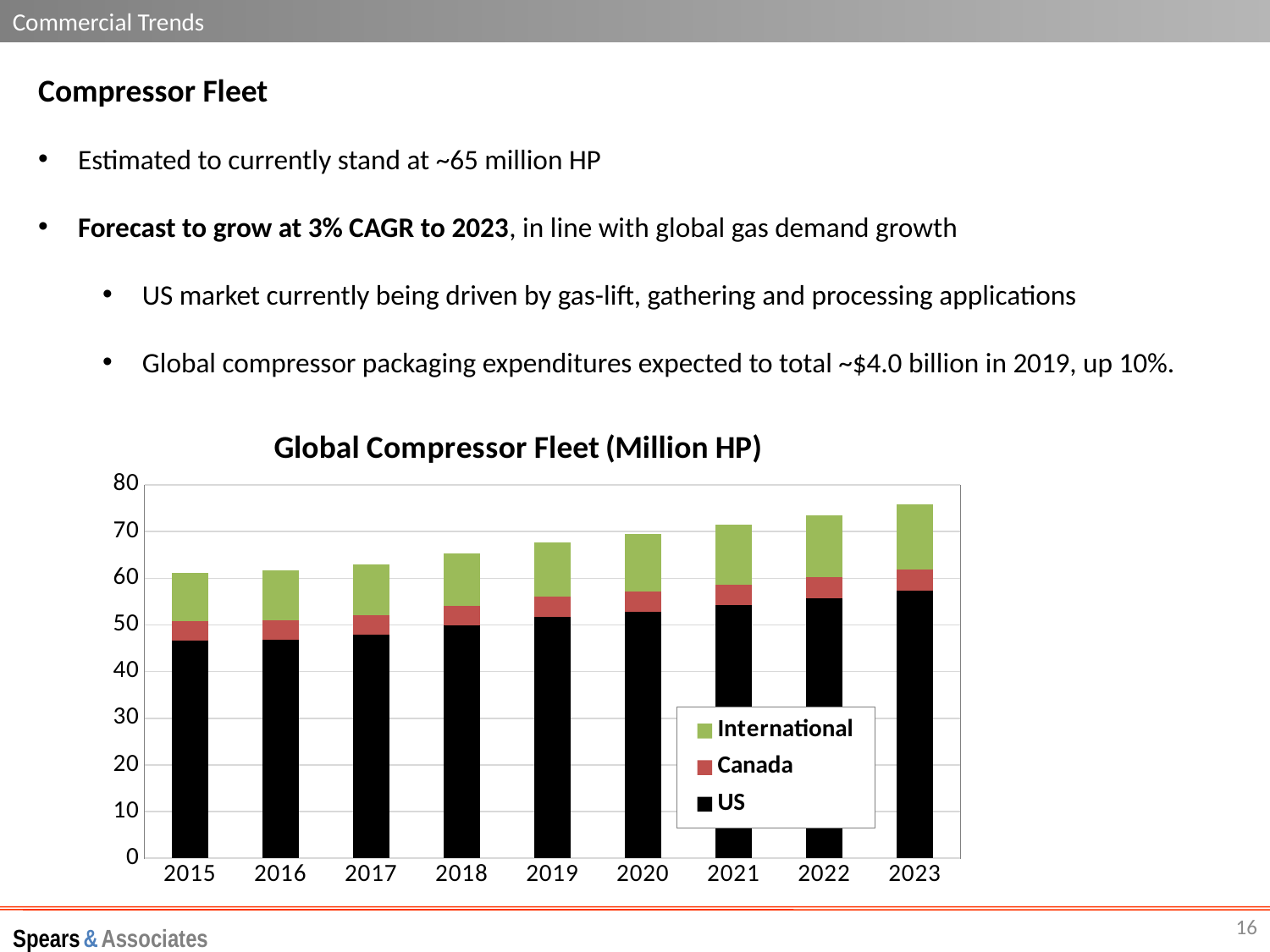
What kind of chart is shown on the slide? Stacked bar chart How many series does the chart's legend list? 3 Which year has the highest total global compressor fleet in the chart? 2023 Is the total fleet value for 2018 greater or less than 70? less Is the total fleet value for 2023 greater or less than 70? greater Which year has the lowest total global compressor fleet in the chart? 2015 How many years are shown on the x axis of the chart? 9 What is the title of the chart? Global Compressor Fleet (Million HP) Is the US segment for 2015 greater or less than 50? less Do the total bar heights rise or fall from 2015 to 2023? Rise Which series is shown in green in the chart? International